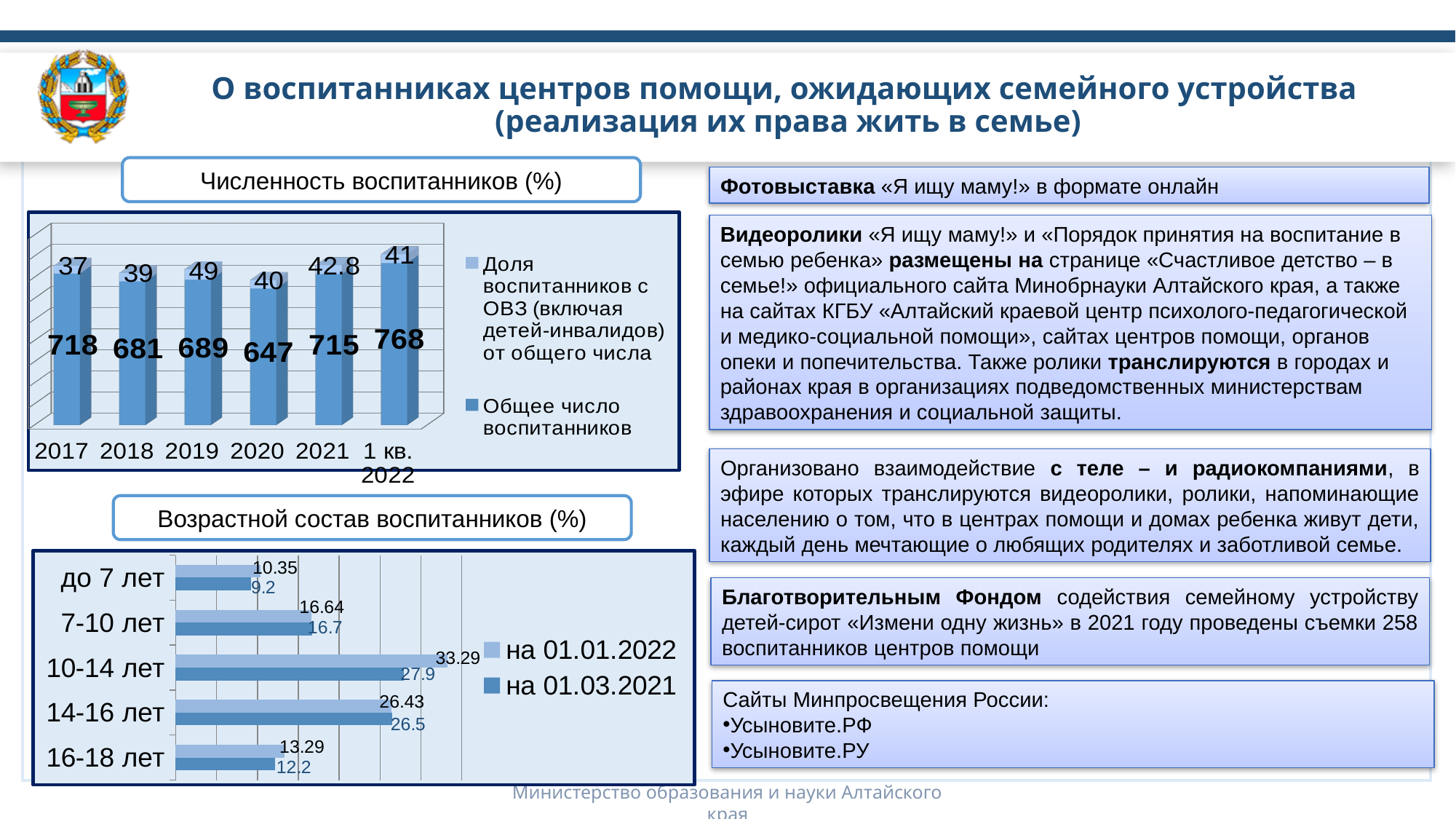
In the chart 'Возрастной состав воспитанников (%)', what is the value for '16-18 лет' on 01.03.2021? 12.2 In the chart 'Возрастной состав воспитанников (%)', which is larger for 'до 7 лет': the value on 01.01.2022 or on 01.03.2021? на 01.01.2022 In the chart 'Численность воспитанников (%)', which year has the highest 'Доля воспитанников с ОВЗ'? 2019 In the chart 'Численность воспитанников (%)', what is the value of 'Общее число воспитанников' for 2017? 718 How many series does the legend of the chart 'Численность воспитанников (%)' list? 2 In the chart 'Численность воспитанников (%)', what is the value of 'Доля воспитанников с ОВЗ' for 2021? 42.8 What kind of chart is 'Возрастной состав воспитанников (%)'? Bar chart In the chart 'Возрастной состав воспитанников (%)', what is the value for '10-14 лет' on 01.01.2022? 33.29 In the chart 'Численность воспитанников (%)', what is the difference between 'Общее число воспитанников' in 1 кв. 2022 and in 2020? 121 In the chart 'Численность воспитанников (%)', which year has the lowest 'Общее число воспитанников'? 2020 In the chart 'Возрастной состав воспитанников (%)', which age group has the highest value on 01.01.2022? 10-14 лет In the chart 'Численность воспитанников (%)', which year has the highest 'Общее число воспитанников'? 1 кв. 2022